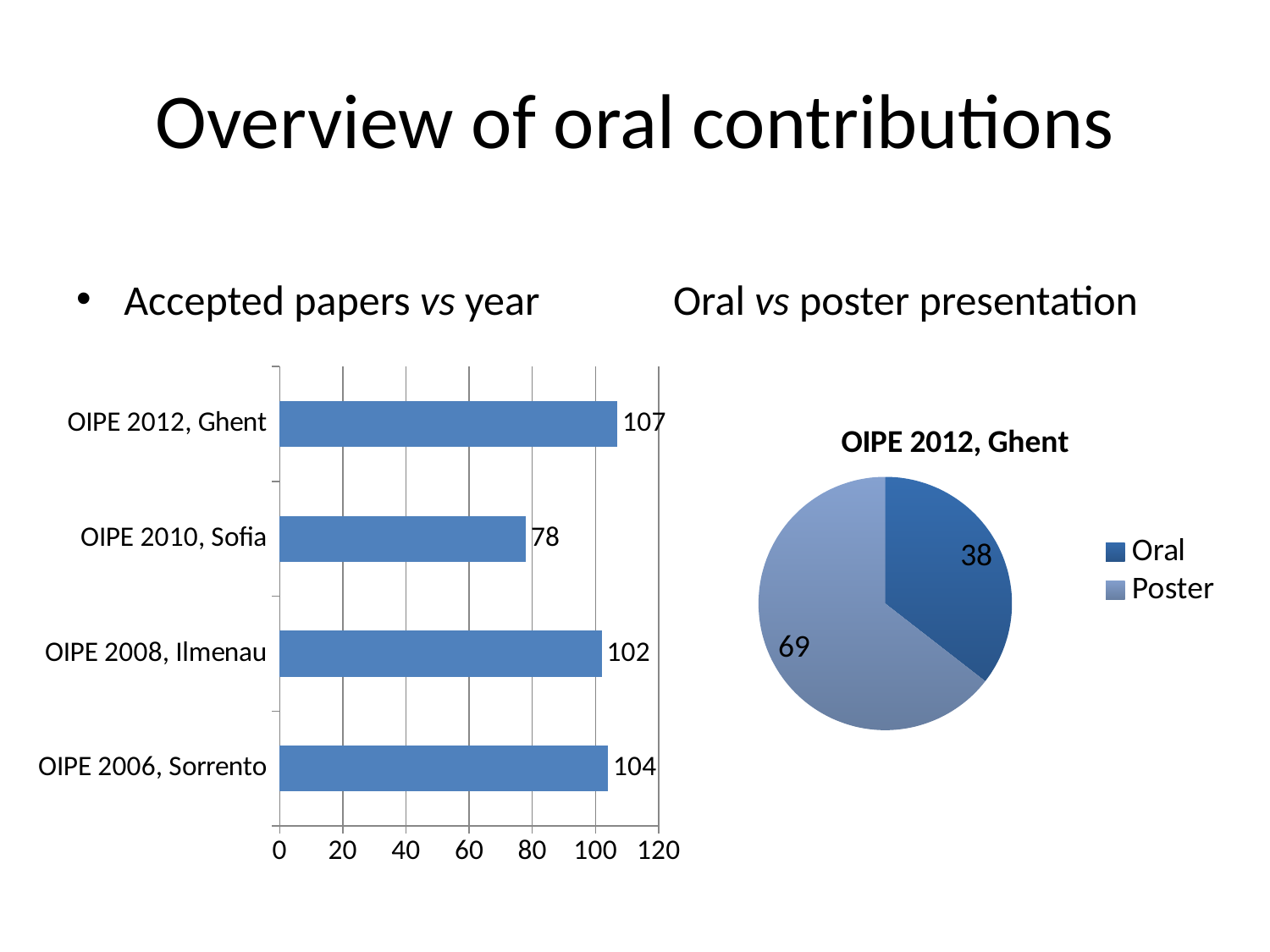
In the pie chart titled OIPE 2012, Ghent, what is the value for Oral? 38 What kind of chart is the chart on the left of the slide? bar chart In the pie chart titled OIPE 2012, Ghent, which is larger, Oral or Poster? Poster In the bar chart on the left, how many accepted papers are shown for OIPE 2012, Ghent? 107 In the bar chart on the left, is the value for OIPE 2010, Sofia greater or less than 80? less In the bar chart on the left, what is the difference between the values for OIPE 2006, Sorrento and OIPE 2008, Ilmenau? 2 In the bar chart on the left, which conference has the highest number of accepted papers? OIPE 2012, Ghent In the bar chart on the left, which conference has the lowest number of accepted papers? OIPE 2010, Sofia How many conferences are shown in the bar chart on the left? 4 In the pie chart titled OIPE 2012, Ghent, what is the total of Oral and Poster? 107 In the bar chart on the left, what is the value for OIPE 2010, Sofia? 78 How many entries does the legend of the pie chart on the right list? 2